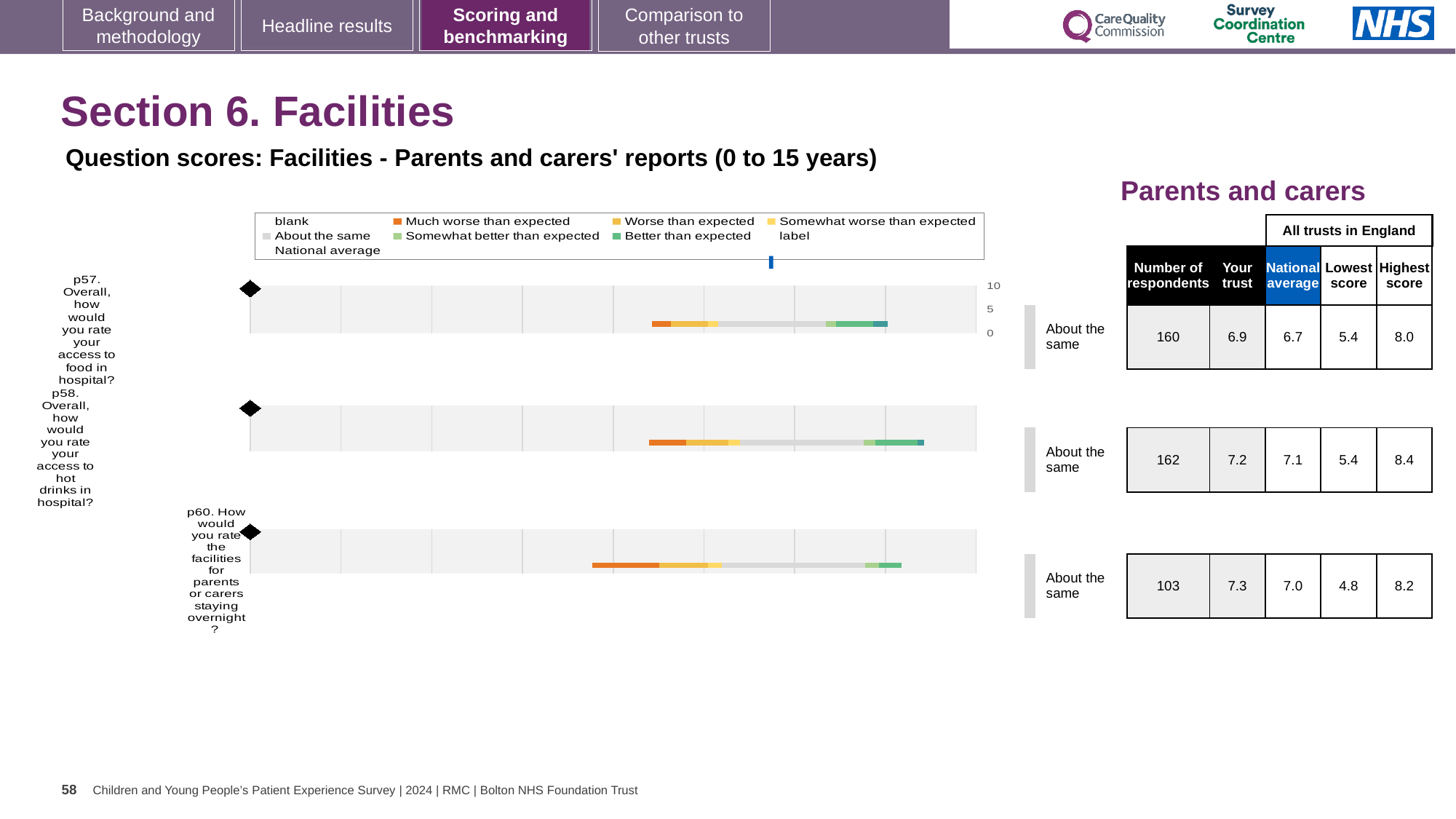
For p58 (access to hot drinks in hospital), what is the National average score? 7.1 What benchmark category is shown for p57 next to its chart? About the same For p60, which is larger: the 'Your trust' score or the National average? Your trust For p60, what is the Lowest score among all trusts in England? 4.8 For p58, what is the difference between the Highest score and the Lowest score? 3.0 For p60 (facilities for parents or carers staying overnight), how many respondents are listed? 103 What colour does the legend use for 'Much worse than expected'? orange What kind of chart is used to show the question scores for p57, p58 and p60? bar chart How many questions (p57, p58, p60) have a benchmark bar chart on this slide? 3 Which of the three questions has the highest 'Your trust' score? p60 For p57 (access to food in hospital), what is the 'Your trust' score shown next to the chart? 6.9 For p57, what is the Highest score among all trusts in England? 8.0